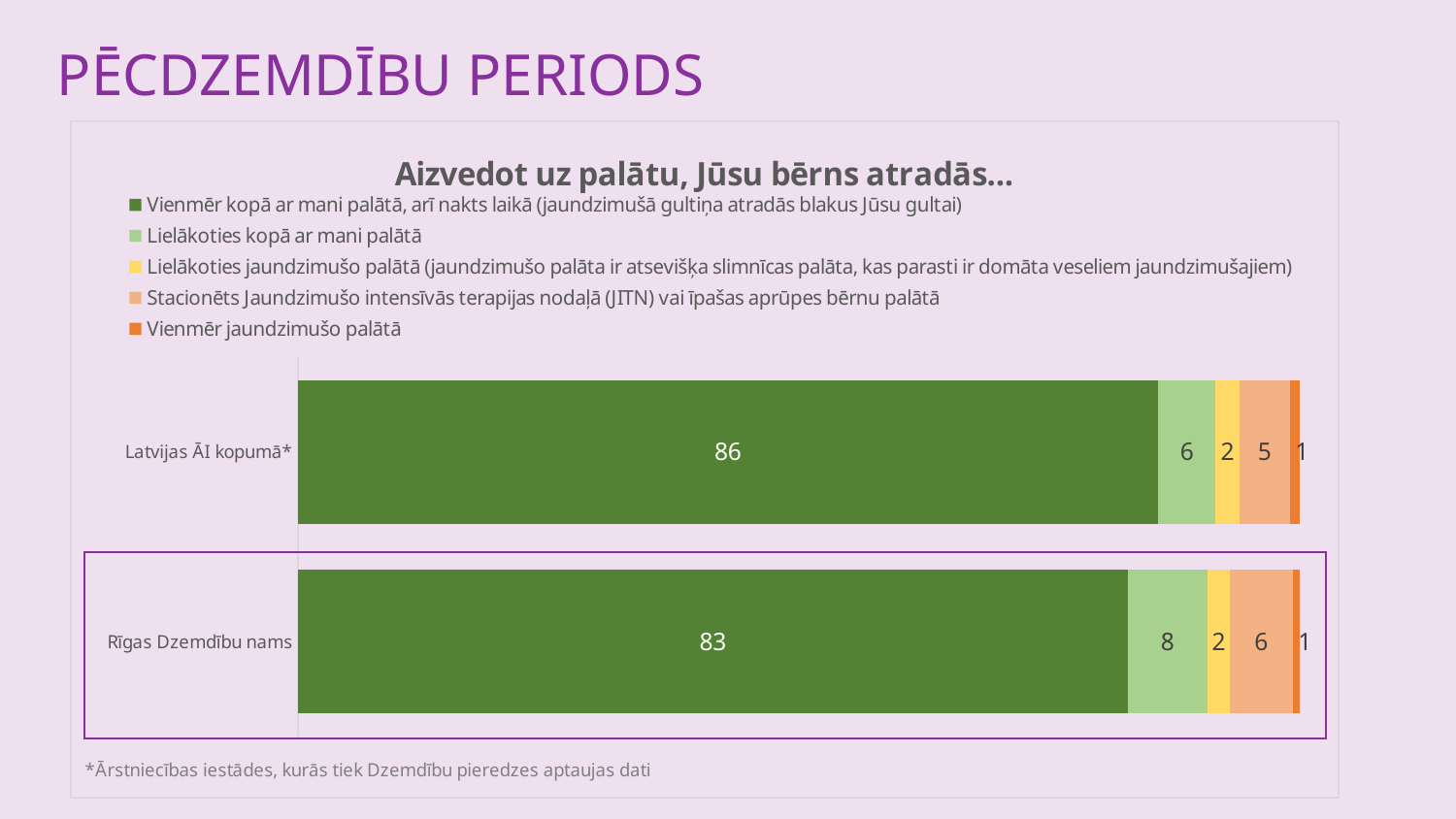
Which category has the larger value for "Lielākoties kopā ar mani palātā": Latvijas ĀI kopumā* or Rīgas Dzemdību nams? Rīgas Dzemdību nams What is the value for "Vienmēr kopā ar mani palātā, arī nakts laikā" for Rīgas Dzemdību nams? 83 What is the value for "Lielākoties kopā ar mani palātā" for Rīgas Dzemdību nams? 8 What is the value for "Stacionēts Jaundzimušo intensīvās terapijas nodaļā (JITN) vai īpašas aprūpes bērnu palātā" for Latvijas ĀI kopumā*? 5 What is the total of the stacked bar for Rīgas Dzemdību nams? 100 How many series does the legend list? 5 What is the value for "Vienmēr kopā ar mani palātā, arī nakts laikā" for Latvijas ĀI kopumā*? 86 What is the title of the chart? Aizvedot uz palātu, Jūsu bērns atradās... What kind of chart is shown on the slide? Stacked bar chart What is the difference between the "Vienmēr kopā ar mani palātā, arī nakts laikā" values for Latvijas ĀI kopumā* and Rīgas Dzemdību nams? 3 How many categories are shown on the chart? 2 What is the value for "Vienmēr jaundzimušo palātā" for Rīgas Dzemdību nams? 1